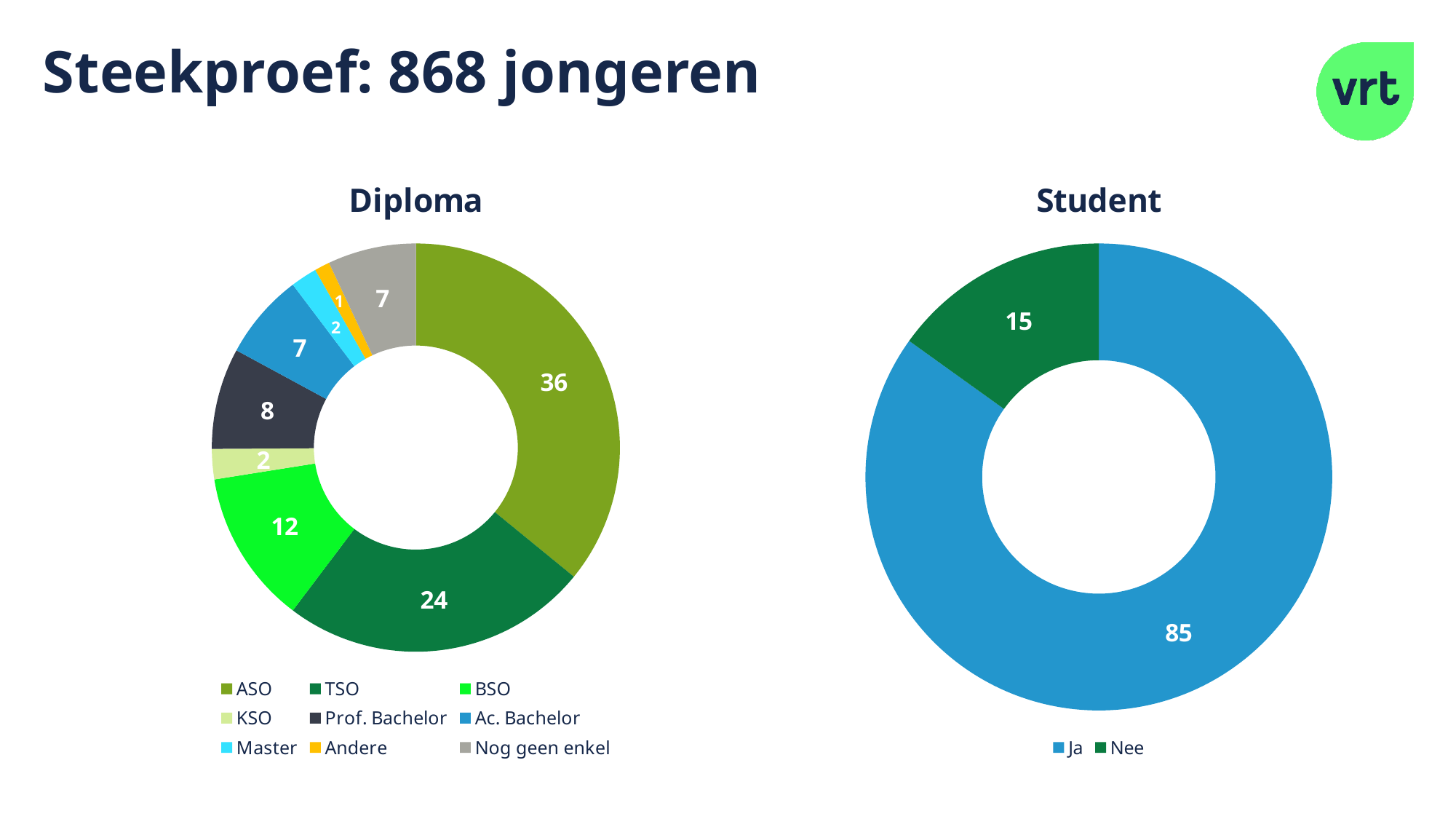
In the Diploma chart, what is the value for ASO? 36 In the Diploma chart, which category has the smallest value? Andere In the Diploma chart, what is the value for Prof. Bachelor? 8 How many entries does the legend of the Student chart list? 2 In the Diploma chart, which is larger: BSO or Prof. Bachelor? BSO In the Student chart, what is the value for Nee? 15 In the Diploma chart, which category has the largest value? ASO In the Diploma chart, what is the value for Nog geen enkel? 7 What kind of chart is the Student chart? doughnut chart In the Student chart, what share of the total does Ja represent? 85% In the Diploma chart, what is the difference between the values for ASO and TSO? 12 How many categories does the Diploma chart show? 9